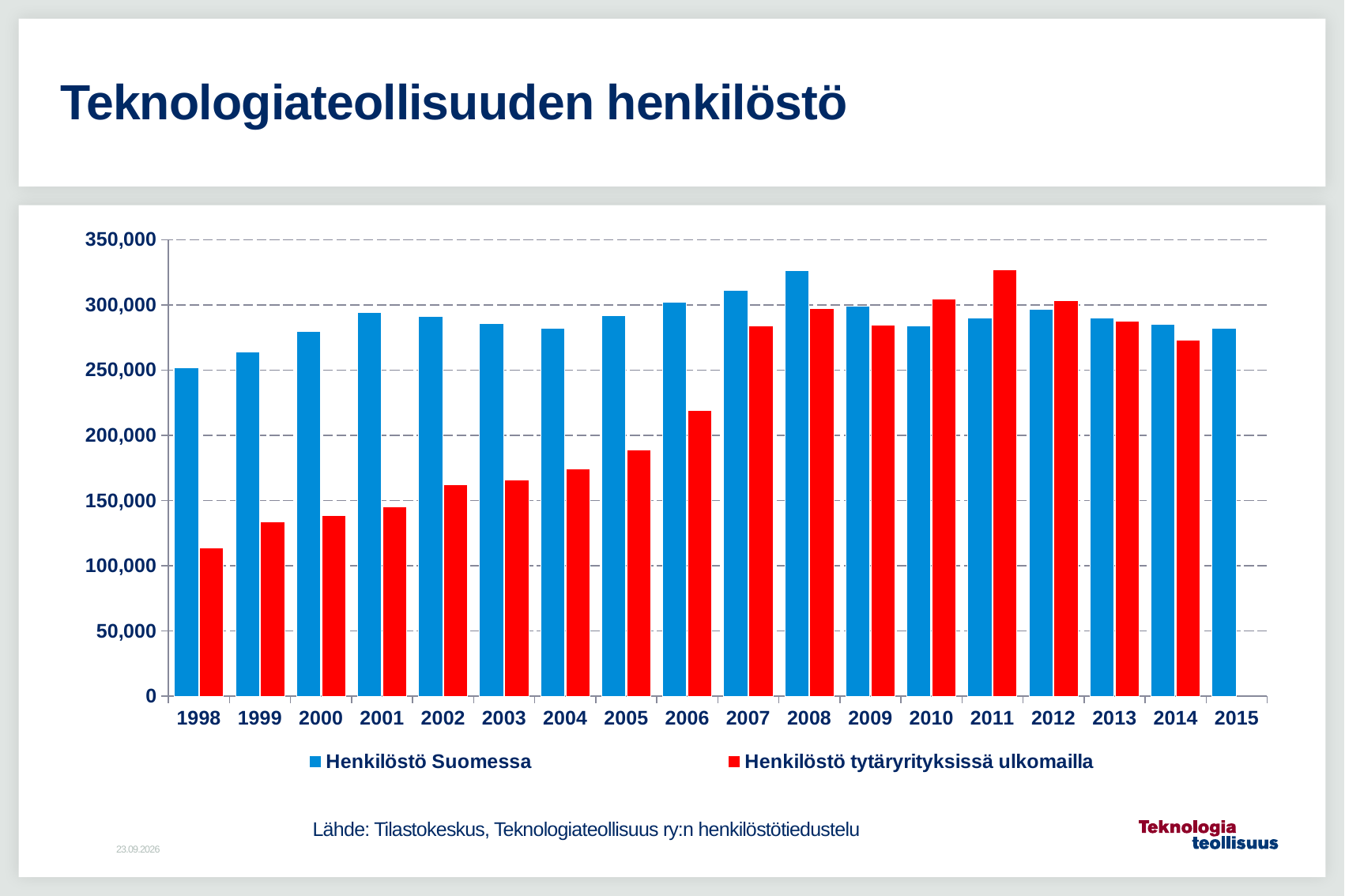
In which year is the value for Henkilöstö tytäryrityksissä ulkomailla lowest? 1998 How many years are shown on the x axis? 18 How many series does the legend list? 2 Is the value for Henkilöstö tytäryrityksissä ulkomailla in 1998 greater or less than 150,000? less In which year is the value for Henkilöstö Suomessa highest? 2008 What kind of chart is shown on the slide? bar chart Is the value for Henkilöstö Suomessa in 2008 greater or less than 300,000? greater In 2011, which series has the larger value, Henkilöstö Suomessa or Henkilöstö tytäryrityksissä ulkomailla? Henkilöstö tytäryrityksissä ulkomailla In 2006, which series has the larger value, Henkilöstö Suomessa or Henkilöstö tytäryrityksissä ulkomailla? Henkilöstö Suomessa Is the value for Henkilöstö tytäryrityksissä ulkomailla in 2011 greater or less than 300,000? greater In which year is the value for Henkilöstö tytäryrityksissä ulkomailla highest? 2011 Do the values for Henkilöstö tytäryrityksissä ulkomailla rise or fall from 1998 to 2011? rise